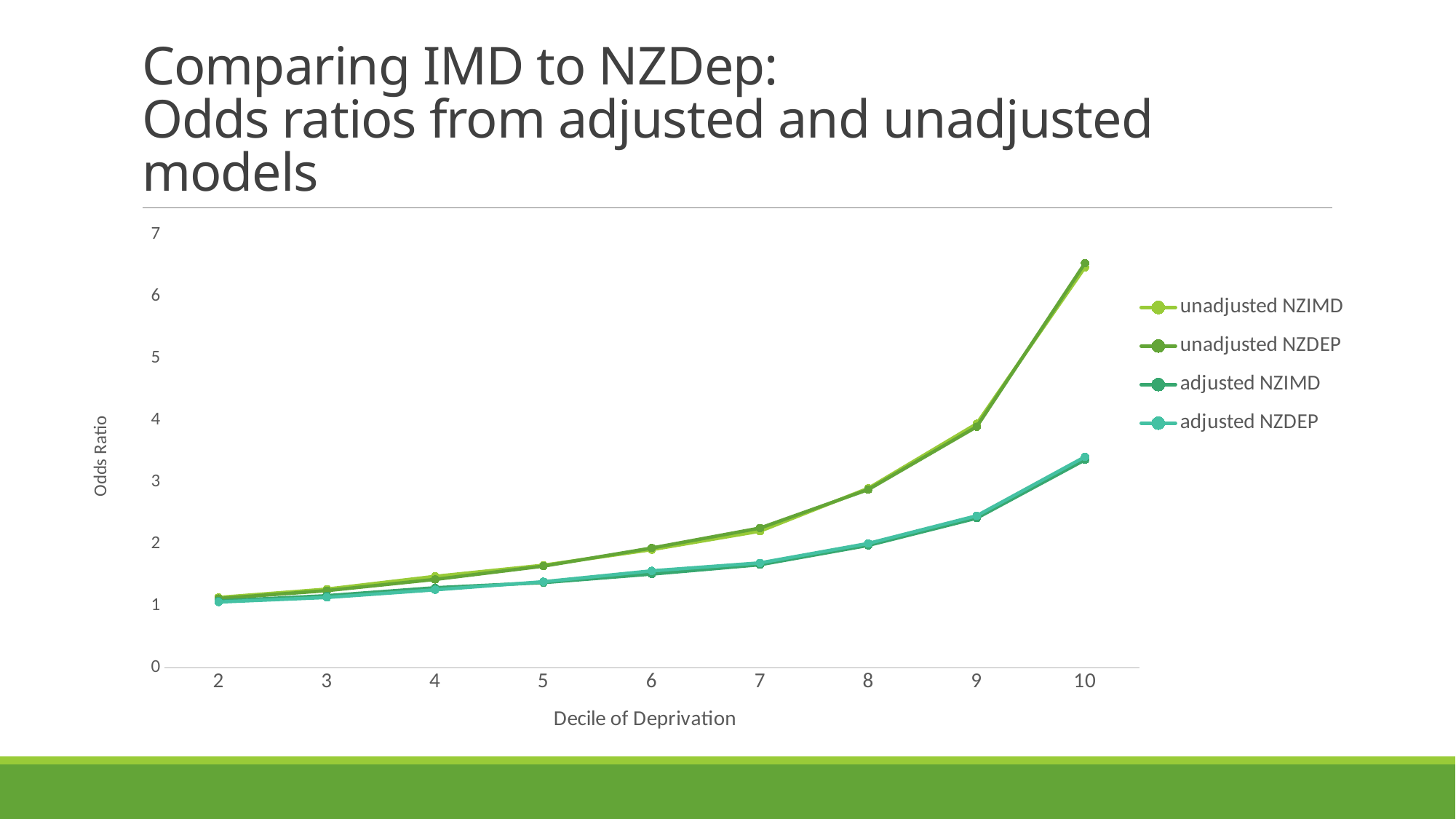
Do the odds ratios rise or fall as the decile of deprivation increases? rise Is the odds ratio for unadjusted NZDEP at decile 10 greater or less than 6? greater Is the odds ratio for adjusted NZIMD at decile 9 greater or less than 2? greater At which decile does the unadjusted NZIMD series reach its highest odds ratio? 10 Is the odds ratio for unadjusted NZIMD at decile 7 greater or less than 3? less What is the label of the y axis? Odds Ratio At decile 10, which is larger: the odds ratio for unadjusted NZDEP or adjusted NZDEP? unadjusted NZDEP How many series does the legend list? 4 What is the label of the x axis? Decile of Deprivation How many deciles are plotted along the x axis? 9 What kind of chart is shown on the slide? line chart